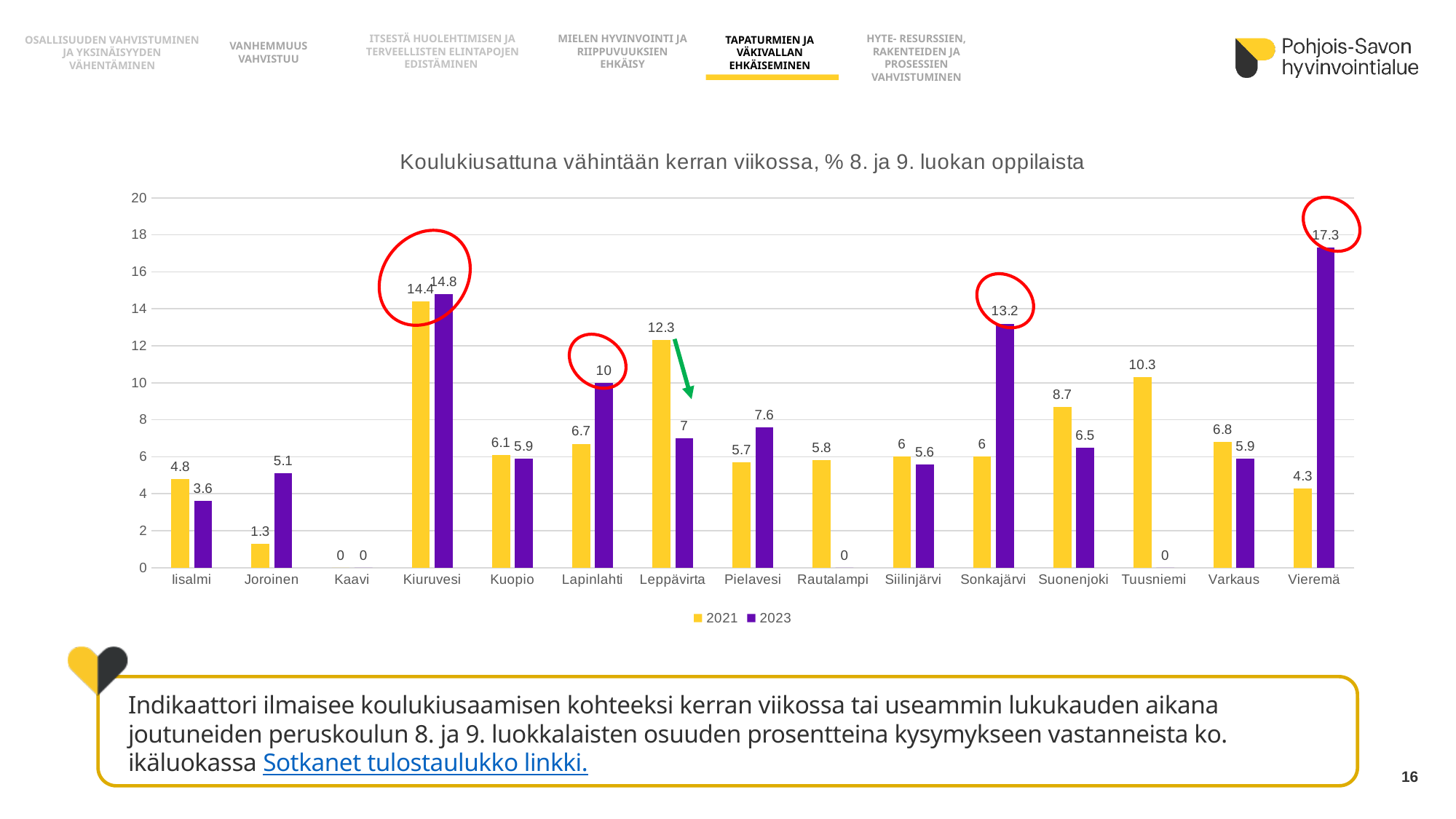
Which is larger for Lapinlahti, the 2021 value or the 2023 value? 2023 What is the difference between the 2023 and 2021 values for Vieremä? 13 What is the difference between the 2021 and 2023 values for Leppävirta? 5.3 What is the 2023 value for Sonkajärvi? 13.2 Which is larger for Suonenjoki, the 2021 value or the 2023 value? 2021 Which municipality has the highest 2021 value? Kiuruvesi What type of chart is shown on the slide? Bar chart How many series does the legend list? 2 How many municipalities are shown on the x axis? 15 Which municipality has the highest 2023 value? Vieremä What is the 2023 value for Vieremä? 17.3 What is the 2021 value for Leppävirta? 12.3